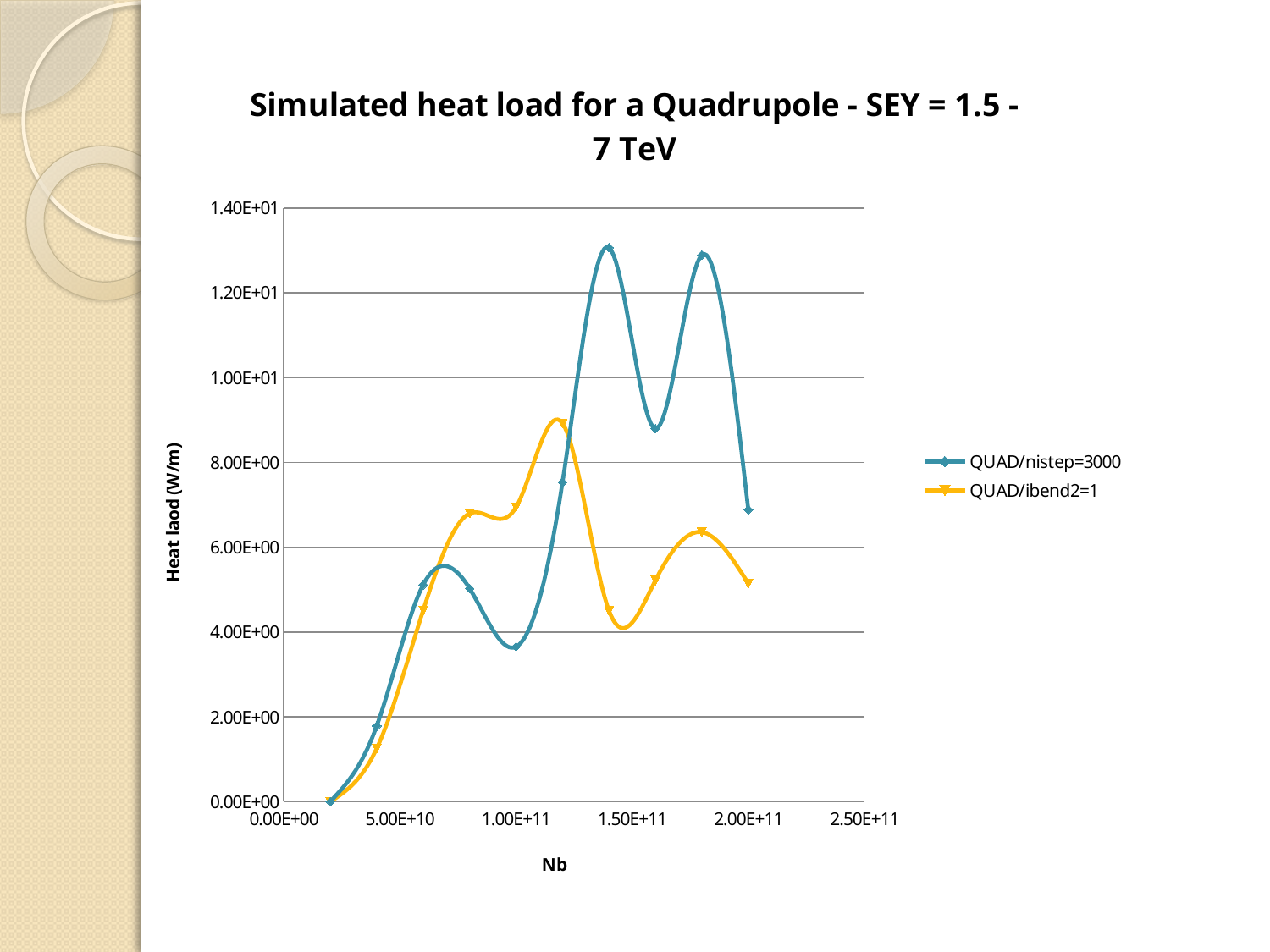
Is the peak value of QUAD/ibend2=1 near Nb = 1.20E+11 greater or less than 8.00E+00? greater At Nb = 1.00E+11, which series has the higher heat load, QUAD/nistep=3000 or QUAD/ibend2=1? QUAD/ibend2=1 Is the value of QUAD/ibend2=1 at Nb = 1.40E+11 greater or less than 6.00E+00? less What kind of chart is shown on the slide? Line chart At Nb = 1.40E+11, which series has the higher heat load, QUAD/nistep=3000 or QUAD/ibend2=1? QUAD/nistep=3000 Is the peak value of QUAD/nistep=3000 near Nb = 1.40E+11 greater or less than 1.20E+01? greater Between Nb = 1.40E+11 and Nb = 1.60E+11, does the QUAD/nistep=3000 series rise or fall? fall What is the label of the vertical axis? Heat laod (W/m) How many series does the legend list? 2 What is the title of the chart? Simulated heat load for a Quadrupole - SEY = 1.5 - 7 TeV Which series reaches the highest heat load value on the chart? QUAD/nistep=3000